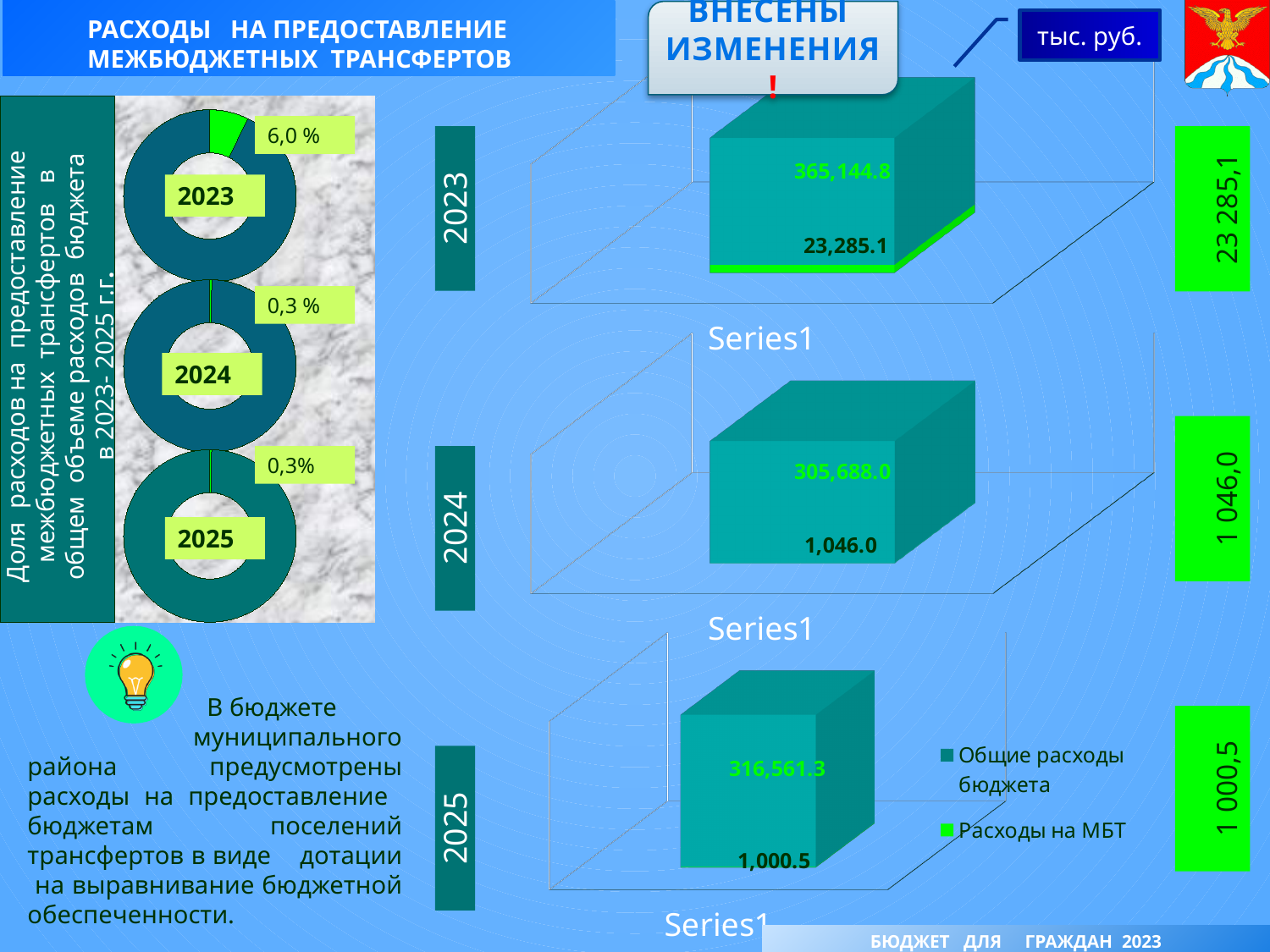
In the 2025 bar chart, what is the value for Общие расходы бюджета? 316,561.3 In the 2024 bar chart, what is the value for Расходы на МБТ? 1,046.0 In the 2023 donut chart on the left, what share of total budget expenses do intergovernmental transfers make up? 6,0 % How many series does the legend of the bar charts list? 2 In the 2025 bar chart, what is the value for Расходы на МБТ? 1,000.5 What is the difference between Расходы на МБТ in the 2024 chart and in the 2025 chart? 45.5 In the 2024 bar chart, what is the value for Общие расходы бюджета? 305,688.0 In the 2024 donut chart on the left, what share is shown for intergovernmental transfers? 0,3 % What kind of chart is used for the 2023, 2024 and 2025 charts on the right side of the slide? Bar chart Which is larger: Общие расходы бюджета in the 2023 chart or in the 2024 chart? 2023 In the 2023 bar chart, what is the value for Общие расходы бюджета? 365,144.8 In the 2023 bar chart, what is the value for Расходы на МБТ? 23,285.1